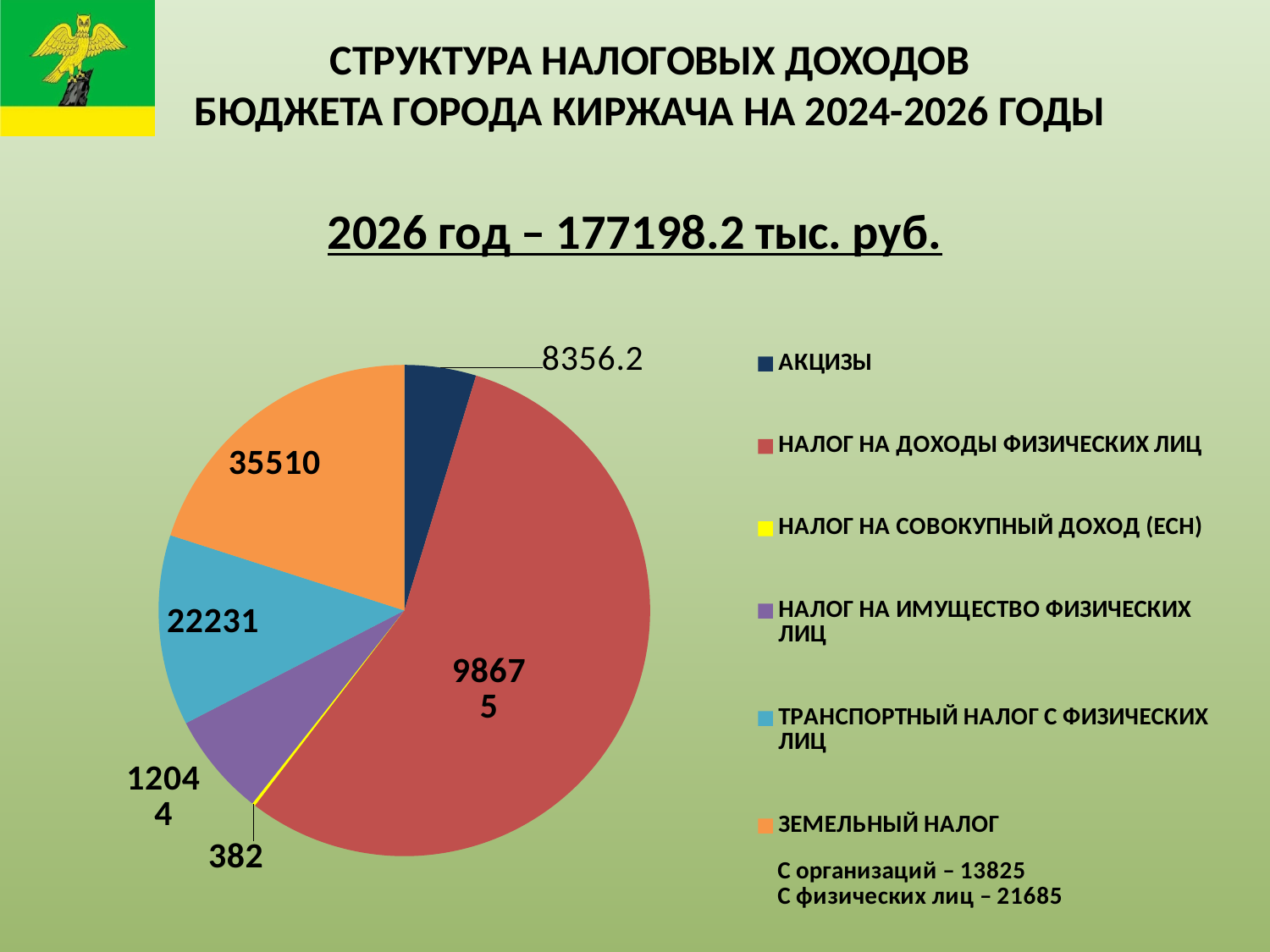
What colour is the slice for ЗЕМЕЛЬНЫЙ НАЛОГ in the pie chart? orange What is the value for АКЦИЗЫ in the pie chart? 8356.2 Which category has the largest slice in the pie chart? НАЛОГ НА ДОХОДЫ ФИЗИЧЕСКИХ ЛИЦ What is the value for ЗЕМЕЛЬНЫЙ НАЛОГ in the pie chart? 35510 What is the difference between the values for ЗЕМЕЛЬНЫЙ НАЛОГ and ТРАНСПОРТНЫЙ НАЛОГ С ФИЗИЧЕСКИХ ЛИЦ? 13279 What is the value for НАЛОГ НА СОВОКУПНЫЙ ДОХОД (ЕСН) in the pie chart? 382 Which is larger: the value for ТРАНСПОРТНЫЙ НАЛОГ С ФИЗИЧЕСКИХ ЛИЦ or the value for НАЛОГ НА ИМУЩЕСТВО ФИЗИЧЕСКИХ ЛИЦ? ТРАНСПОРТНЫЙ НАЛОГ С ФИЗИЧЕСКИХ ЛИЦ What is the value for ТРАНСПОРТНЫЙ НАЛОГ С ФИЗИЧЕСКИХ ЛИЦ in the pie chart? 22231 How many categories does the legend of the pie chart list? 6 Which category has the smallest slice in the pie chart? НАЛОГ НА СОВОКУПНЫЙ ДОХОД (ЕСН) What is the value for НАЛОГ НА ИМУЩЕСТВО ФИЗИЧЕСКИХ ЛИЦ in the pie chart? 12044 What type of chart is shown on the slide? pie chart